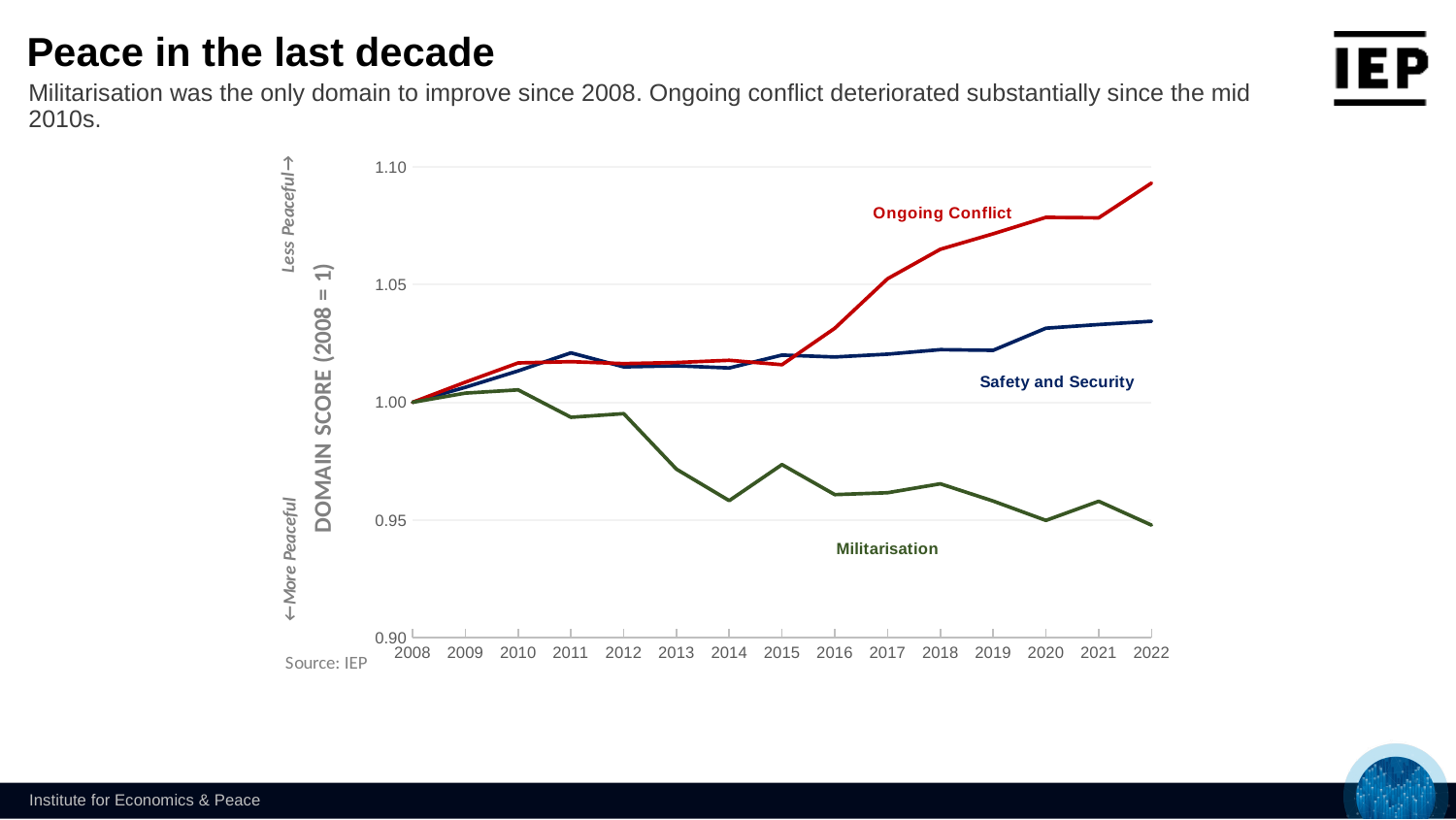
Is the value for Safety and Security in 2022 greater or less than 1.05? less What is the domain score for Militarisation in 2008? 1.00 How many years are shown along the x axis of the chart? 15 Which series has the highest value in 2022? Ongoing Conflict What colour is the Ongoing Conflict line? red Which is larger in 2022, Ongoing Conflict or Safety and Security? Ongoing Conflict Does the Militarisation line generally rise or fall from 2008 to 2022? fall Which series has the lowest value in 2022? Militarisation How many series are plotted on the chart? 3 Is the value for Ongoing Conflict in 2022 greater or less than 1.05? greater What kind of chart is shown on the slide? line chart